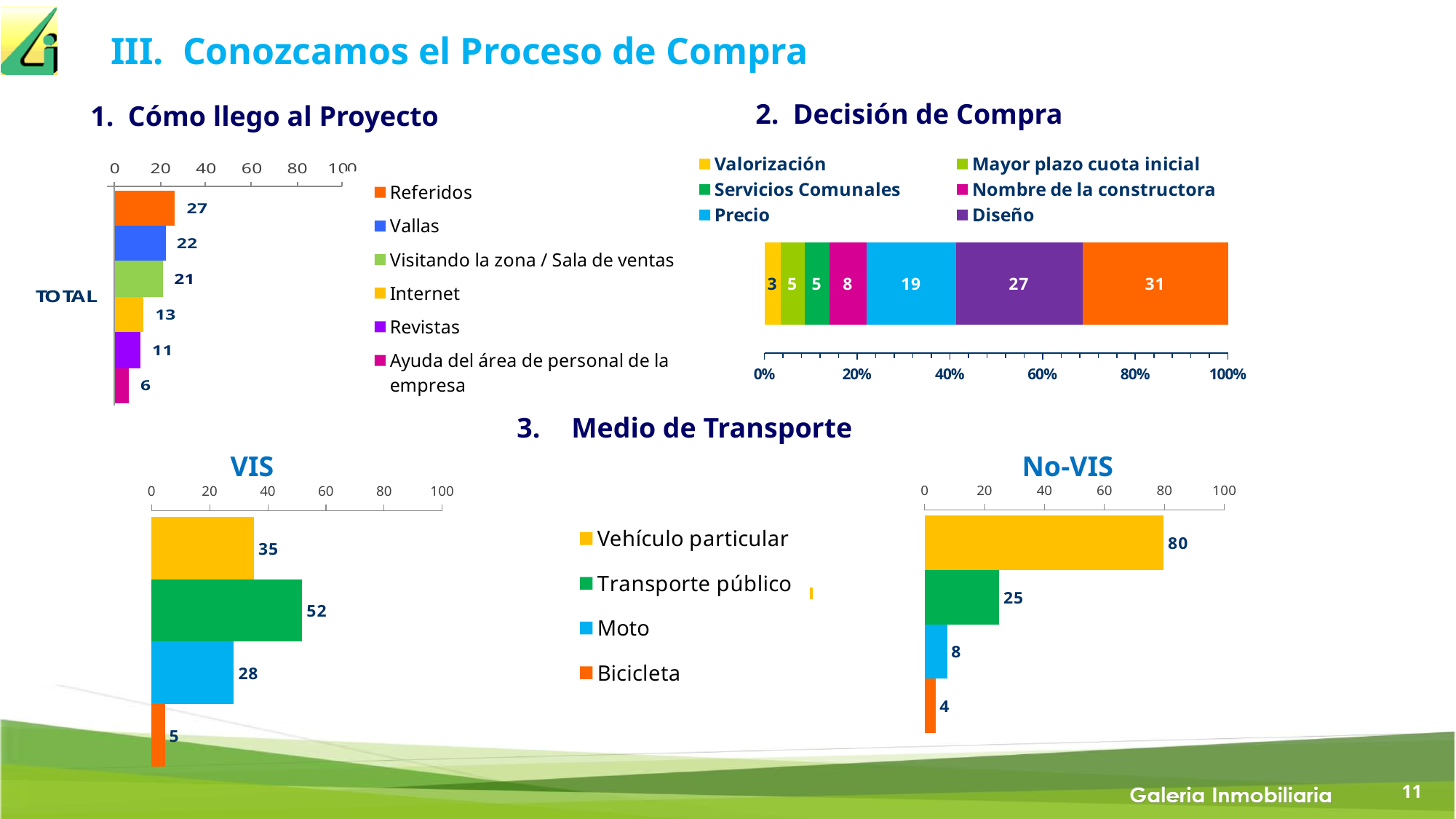
In the 'Cómo llego al Proyecto' chart, what is the difference between Vallas and Internet? 9 In the 'Cómo llego al Proyecto' chart, how many series does the legend list? 6 In the 'Decisión de Compra' chart, what is the total of all the segments in the stacked bar? 98 In the 'Cómo llego al Proyecto' chart, what is the value for Referidos? 27 In the 'Decisión de Compra' chart, which is larger, Servicios Comunales or Nombre de la constructora? Nombre de la constructora What is the difference between the Moto value in the VIS chart and the Moto value in the No-VIS chart? 20 In the VIS chart under 'Medio de Transporte', what is the value for Transporte público? 52 In the No-VIS chart under 'Medio de Transporte', which category has the highest value? Vehículo particular In the 'Decisión de Compra' chart, what is the value for Diseño? 27 What kind of chart is the VIS chart under 'Medio de Transporte'? Bar chart In the 'Cómo llego al Proyecto' chart, which category has the lowest value? Ayuda del área de personal de la empresa In the 'Decisión de Compra' chart, what is the value for Precio? 19